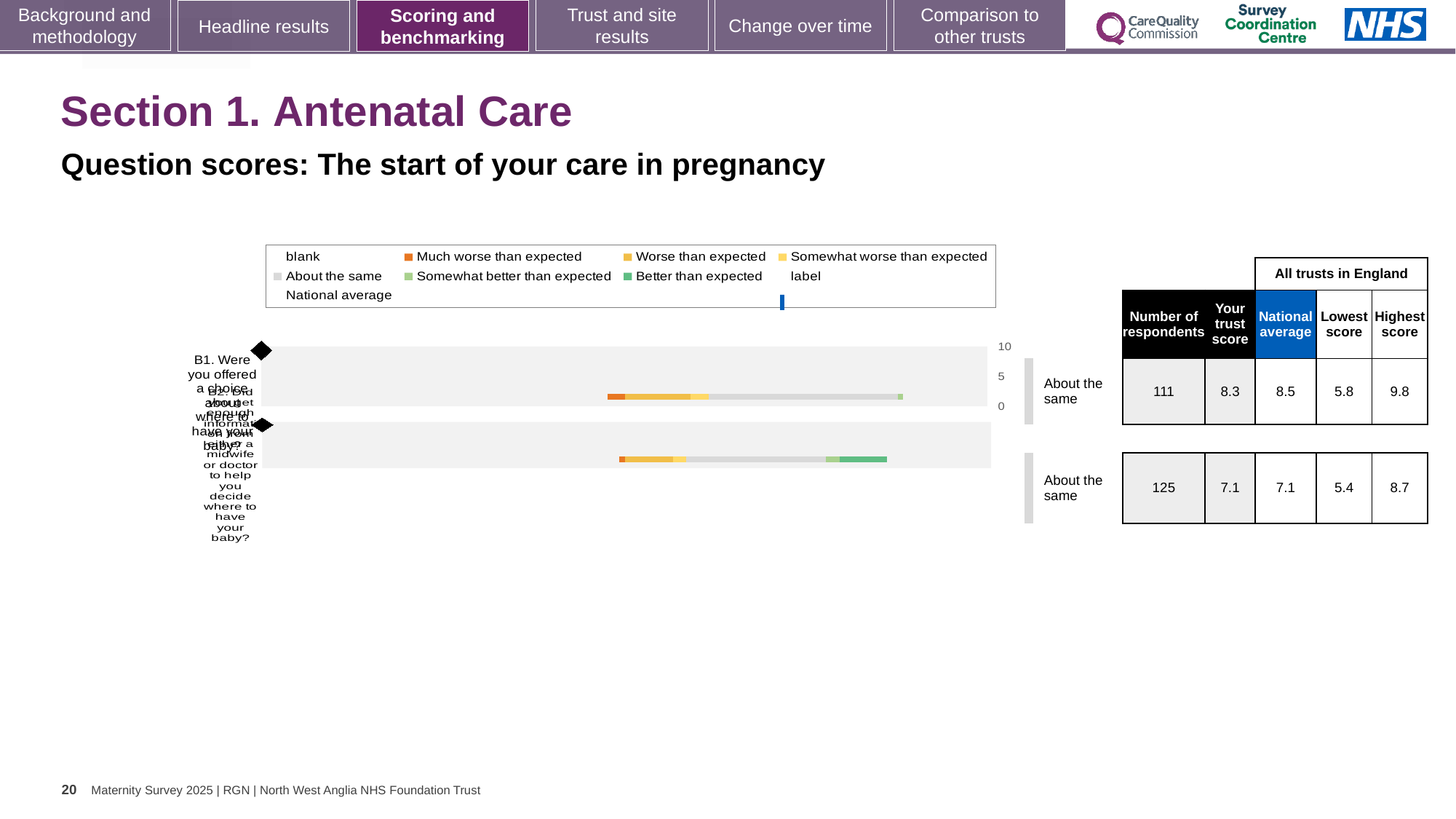
In the table beside the chart, what is the lowest score in the first row? 5.8 In the table beside the chart, what is the number of respondents in the second row? 125 In the first row of the table, which is larger: the trust score or the national average? national average What benchmark category is shown next to the chart for both questions? About the same Which row of the table has the larger number of respondents, the first or the second? second In the table beside the chart, what is the national average in the first row? 8.5 In the table beside the chart, what is the highest score in the second row? 8.7 In the table beside the chart, what is the difference between the highest score and the lowest score in the first row? 4.0 In the table beside the chart, what is the 'Your trust score' value in the first row? 8.3 In the second row of the table, is the trust score higher than, lower than, or the same as the national average? the same How many survey questions (bars) are plotted in the chart? 2 What kind of chart is shown on the slide? bar chart